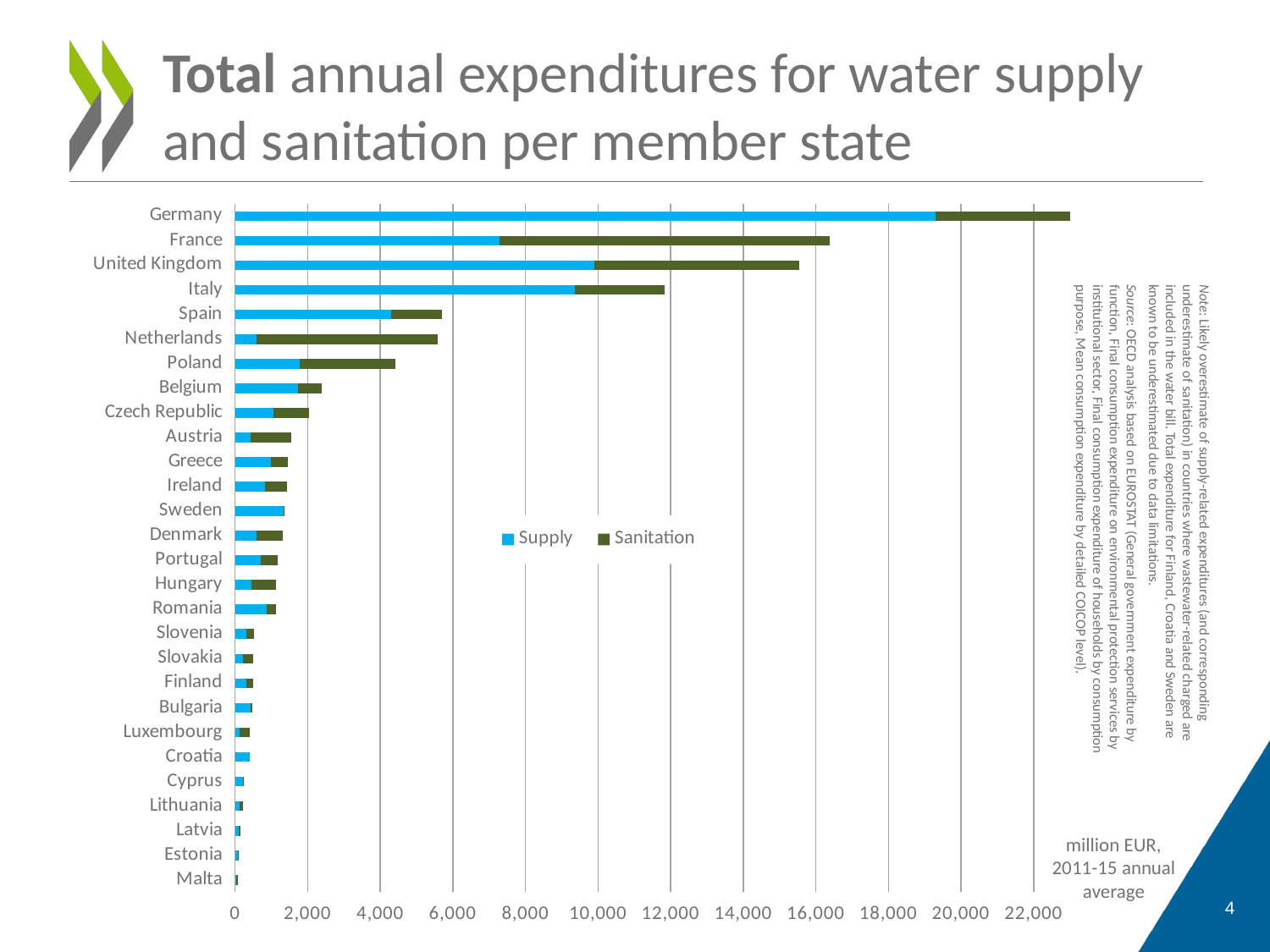
Is the Supply expenditure for the Netherlands greater or less than 2,000? less Is the total expenditure for the United Kingdom greater or less than 16,000? less Which has the larger total expenditure, Italy or Spain? Italy How many series does the legend list? 2 Is the total expenditure for Germany greater or less than 20,000? greater Which member state has the lowest total annual expenditure? Malta How many member states are plotted on the chart? 28 What kind of chart is shown on the slide? Stacked bar chart Which member state has the highest total annual expenditure? Germany Which colour represents the Sanitation series in the chart? Dark green Which has the larger total expenditure, France or the United Kingdom? France